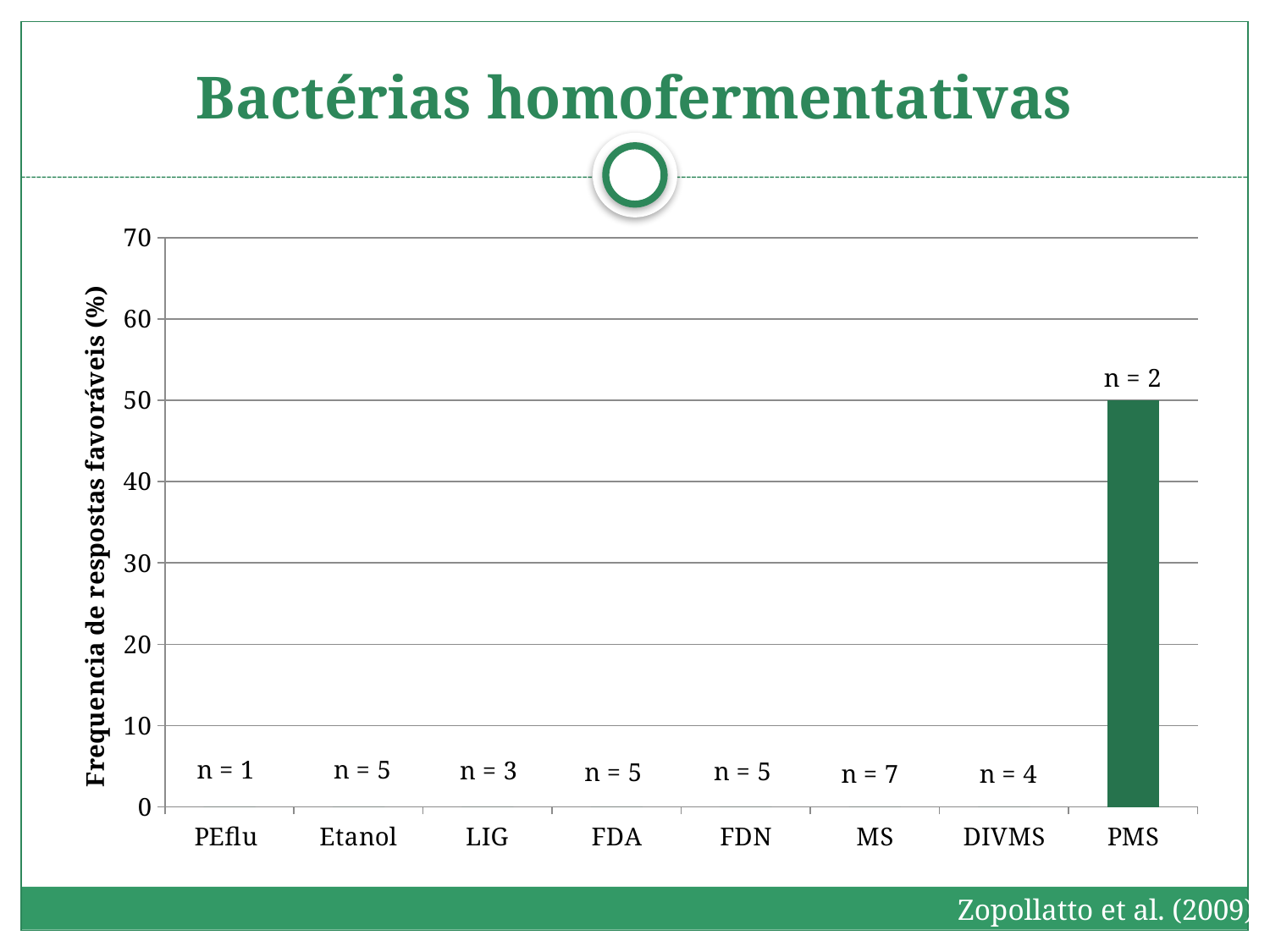
Is the value for PMS greater or less than 60? less What is the frequency of favourable responses (%) for PMS? 50 How many categories have a visible bar above zero? 1 What is the title of the y axis? Frequencia de respostas favoráveis (%) What n value is printed above the MS category? n = 7 Which is larger, the value for PMS or the value for DIVMS? PMS Which category has the highest frequency of favourable responses? PMS How many categories are shown on the x axis of the chart? 8 What kind of chart is shown on the slide? bar chart Is the value for MS greater or less than 10? less Is the value for PMS greater or less than 40? greater